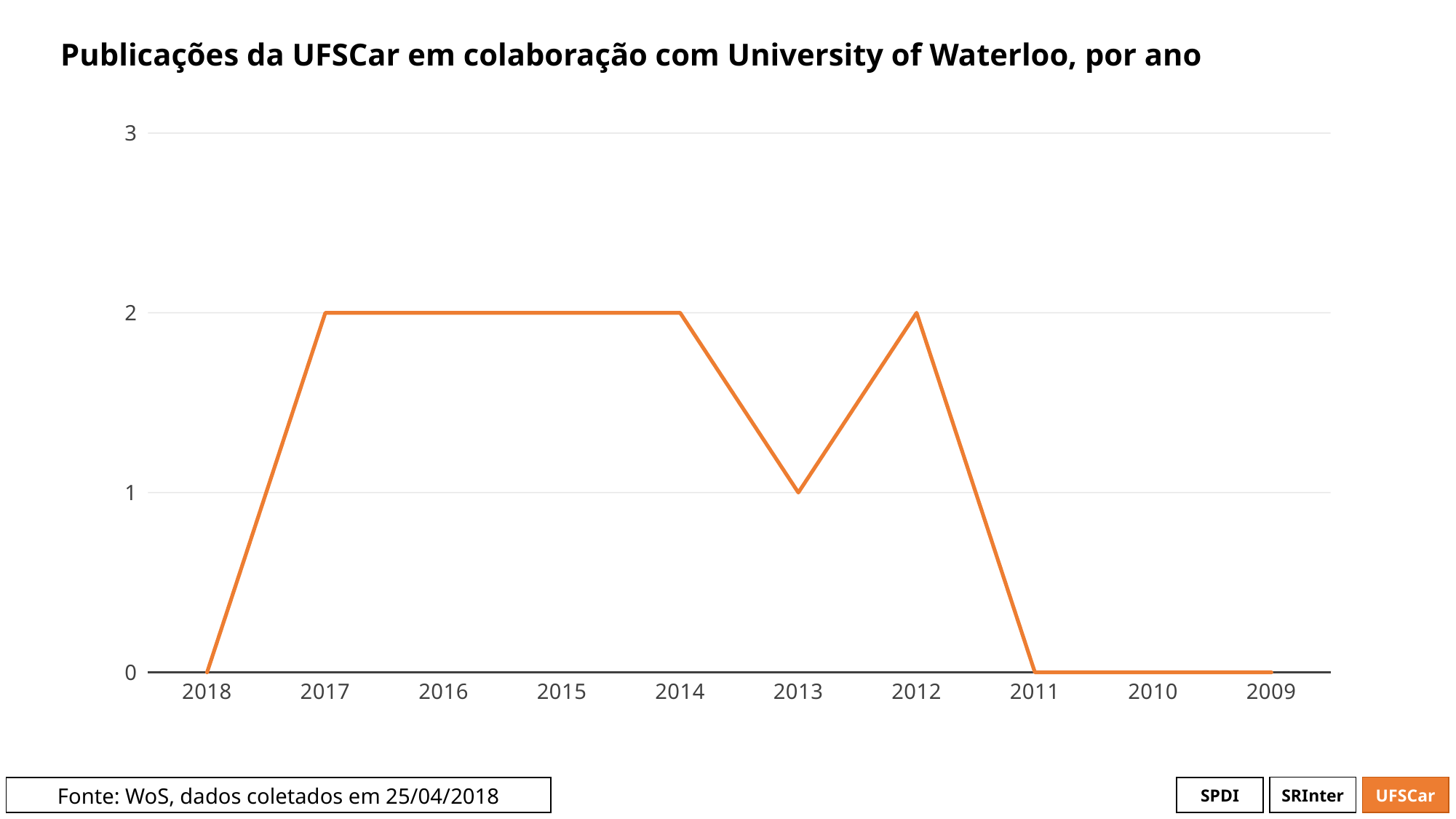
What is the value for 2017? 2 What is the value for 2018? 0 What type of chart is shown on the slide? Line chart What is the value for 2011? 0 Is the value for 2016 greater or less than 1? greater How many years are shown on the x axis? 10 What is the value for 2012? 2 What is the highest value reached on the chart? 2 What is the difference between the value for 2012 and the value for 2013? 1 What is the title of the chart? Publicações da UFSCar em colaboração com University of Waterloo, por ano What is the value for 2013? 1 Which is larger, the value for 2014 or the value for 2013? 2014